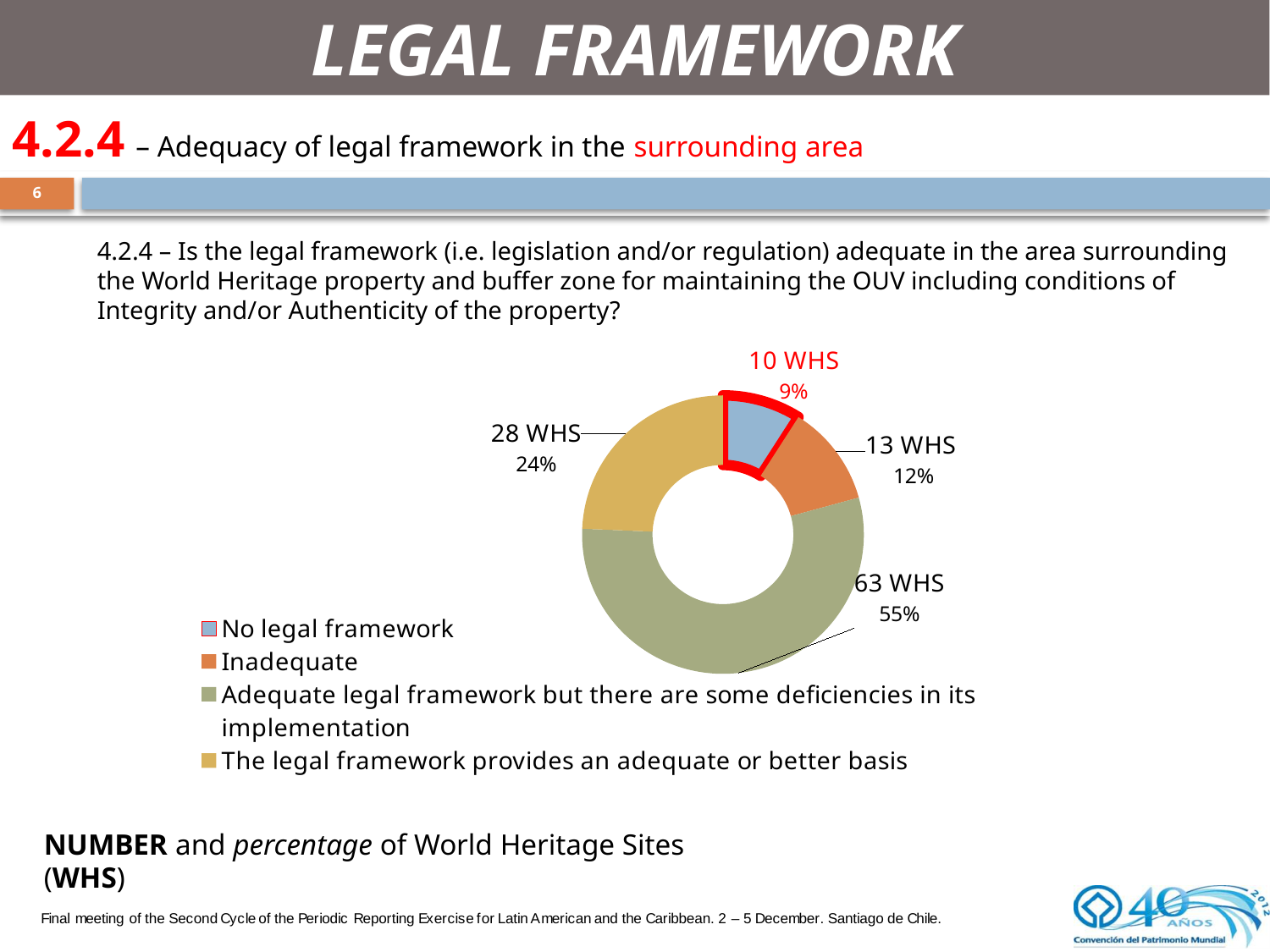
Which category accounts for the largest share of World Heritage Sites? Adequate legal framework but there are some deficiencies in its implementation Which category accounts for the smallest share of World Heritage Sites? No legal framework Which has more World Heritage Sites: 'Inadequate' or 'No legal framework'? Inadequate How many World Heritage Sites have no legal framework in the surrounding area? 10 WHS What percentage of World Heritage Sites fall in the 'Inadequate' category? 12% What kind of chart is shown on the slide? Doughnut (pie) chart How many categories does the chart show? 4 How many more World Heritage Sites are in the 'Adequate legal framework but there are some deficiencies in its implementation' category than in the 'The legal framework provides an adequate or better basis' category? 35 What is the total number of World Heritage Sites represented in the chart? 114 How many World Heritage Sites have an adequate legal framework but with some deficiencies in its implementation? 63 WHS What share of World Heritage Sites report that the legal framework provides an adequate or better basis? 24% Which slice of the chart is outlined in red? No legal framework (10 WHS, 9%)